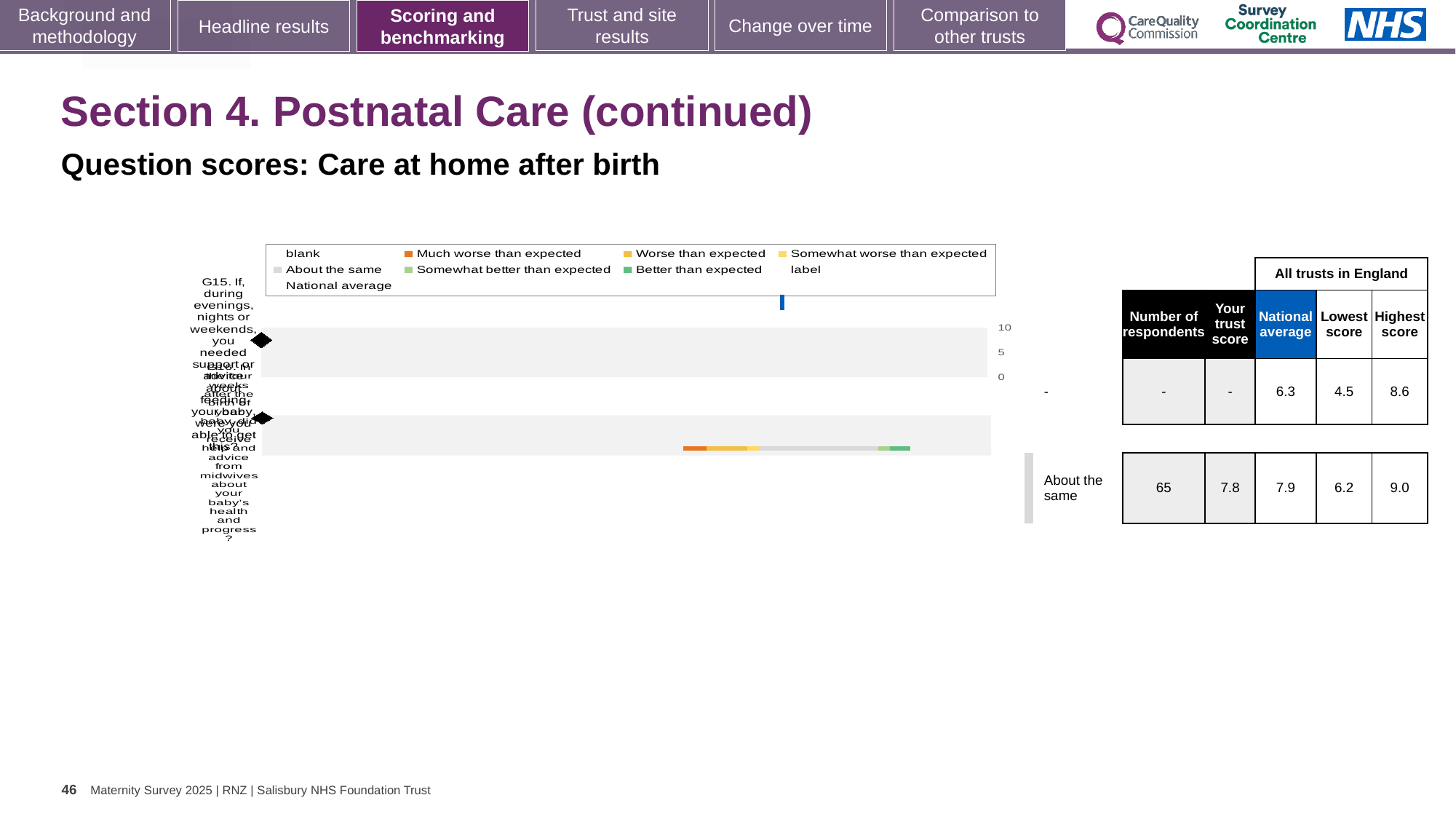
In the table next to the chart, what is the number of respondents for the row labelled 'About the same'? 65 In the table next to the chart, what is the difference between the highest score and the lowest score for the first (top) row? 4.1 In the table next to the chart, what is 'Your trust score' for the row labelled 'About the same'? 7.8 Which legend entry is shown in orange? Much worse than expected In the table next to the chart, which is larger for the 'About the same' row: your trust score or the national average? National average In the table next to the chart, what is the national average for the row labelled 'About the same'? 7.9 In the table next to the chart, what is the lowest score for the row labelled 'About the same'? 6.2 What kind of chart is shown on the slide? bar chart In the table next to the chart, what is the highest score for the row labelled 'About the same'? 9.0 In the table next to the chart, what is the difference between the highest score and the lowest score for the 'About the same' row? 2.8 In the table next to the chart, what is the national average for the first (top) row? 6.3 Which legend entry is shown in dark green? Better than expected